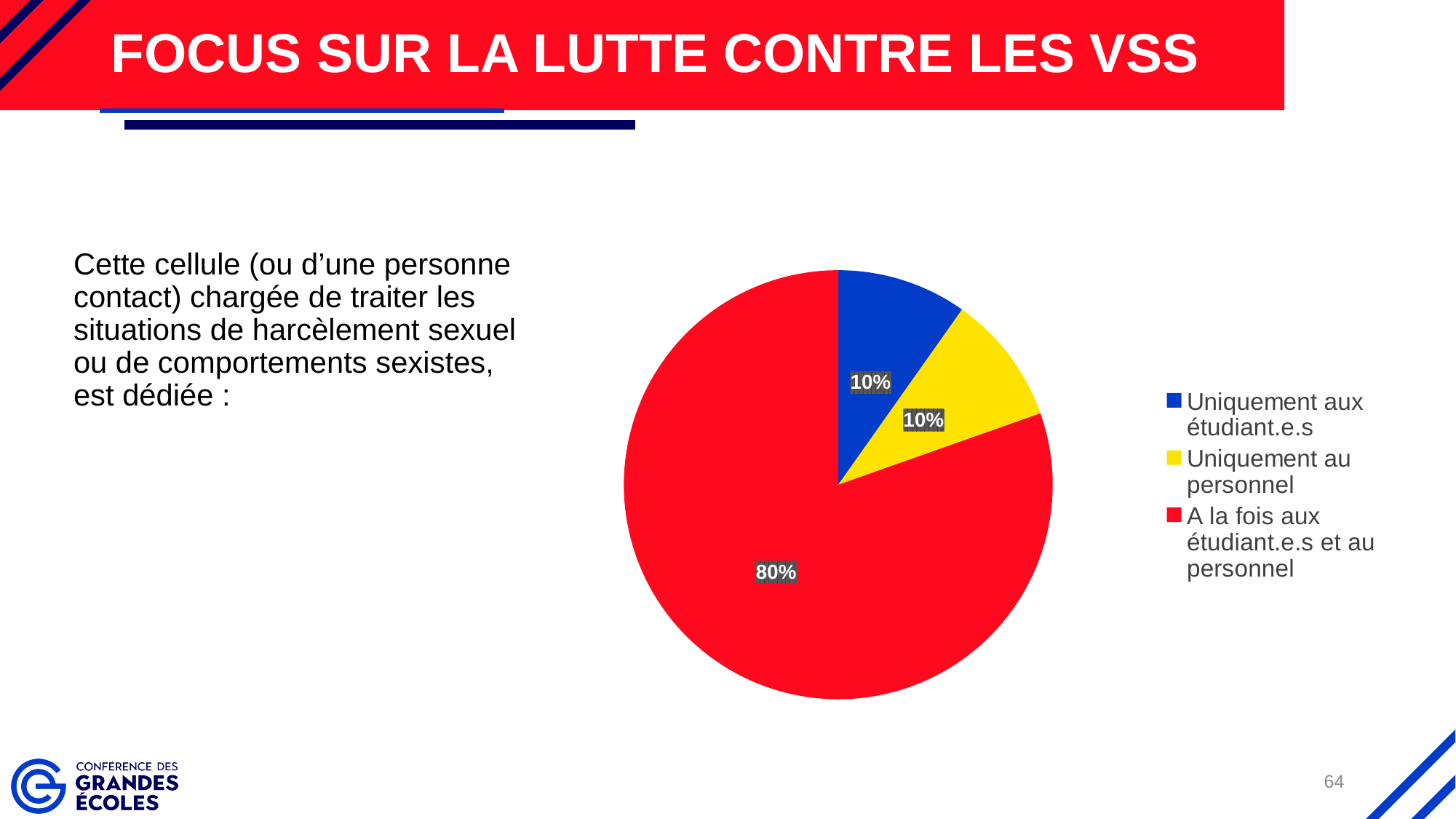
How many slices does the pie chart have? 3 How many entries does the legend list? 3 Which category has the largest slice of the pie? A la fois aux étudiant.e.s et au personnel What is the difference between the share for 'A la fois aux étudiant.e.s et au personnel' and the share for 'Uniquement au personnel'? 70% What share of the pie is 'A la fois aux étudiant.e.s et au personnel'? 80% What share of the pie is 'Uniquement au personnel'? 10% What share of the pie is 'Uniquement aux étudiant.e.s'? 10% Which is larger: the slice for 'A la fois aux étudiant.e.s et au personnel' or the slice for 'Uniquement aux étudiant.e.s'? A la fois aux étudiant.e.s et au personnel What colour is the slice for 'Uniquement au personnel'? yellow What type of chart is shown on the slide? pie chart What is the combined share of 'Uniquement aux étudiant.e.s' and 'Uniquement au personnel'? 20% What colour is the slice for 'A la fois aux étudiant.e.s et au personnel'? red